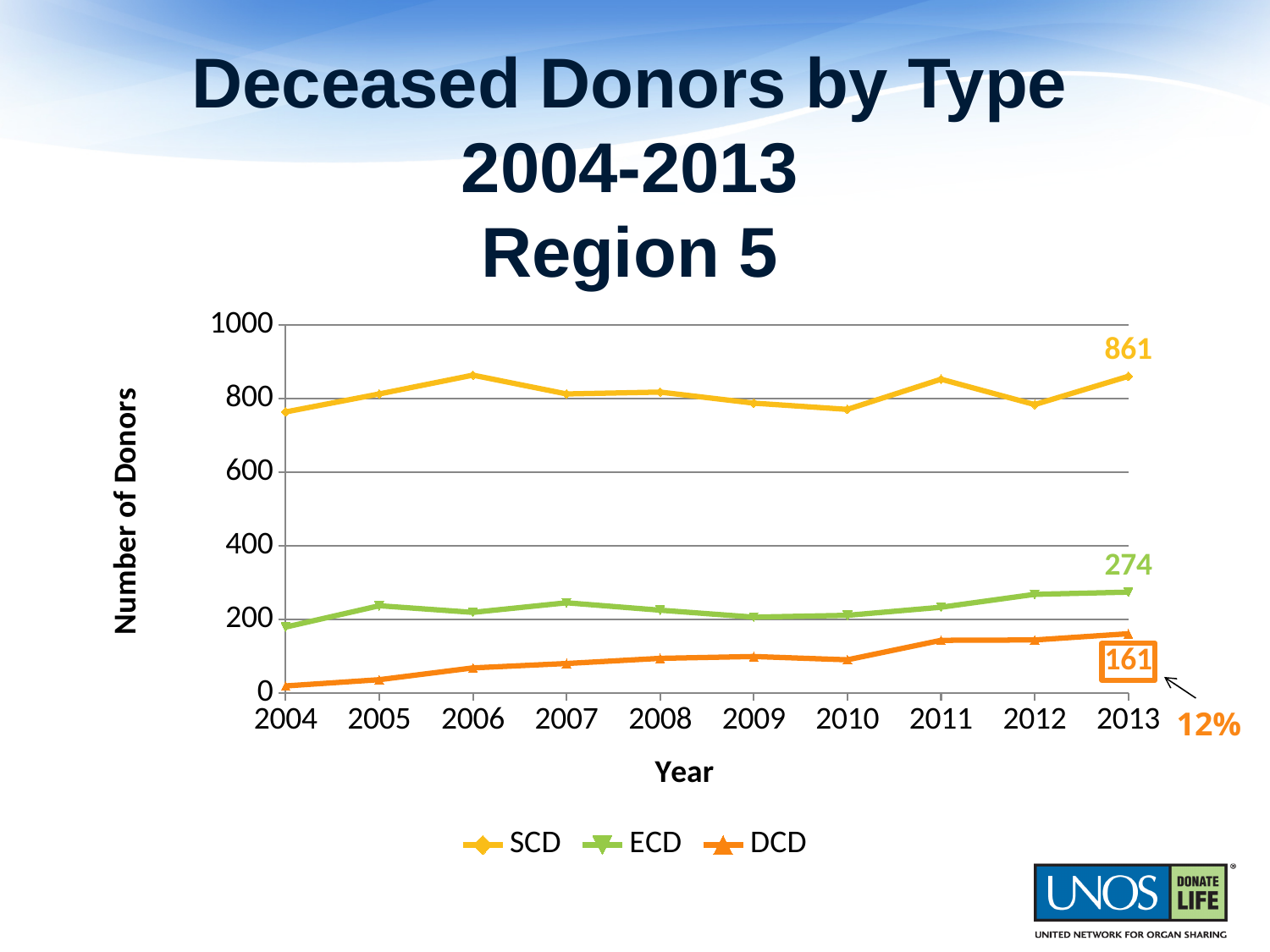
Is the value for DCD in 2004 greater or less than 100? less What kind of chart is shown on the slide? line chart Which series has the highest value in 2013? SCD How many series does the legend list? 3 What is the difference between the ECD and DCD values in 2013? 113 What is the value for DCD in 2013? 161 What is the value for ECD in 2013? 274 Is the value for SCD in 2004 greater or less than 800? less Which series has the lowest value in 2013? DCD How many years are shown on the x axis? 10 What is the value for SCD in 2013? 861 What is the difference between the SCD and ECD values in 2013? 587